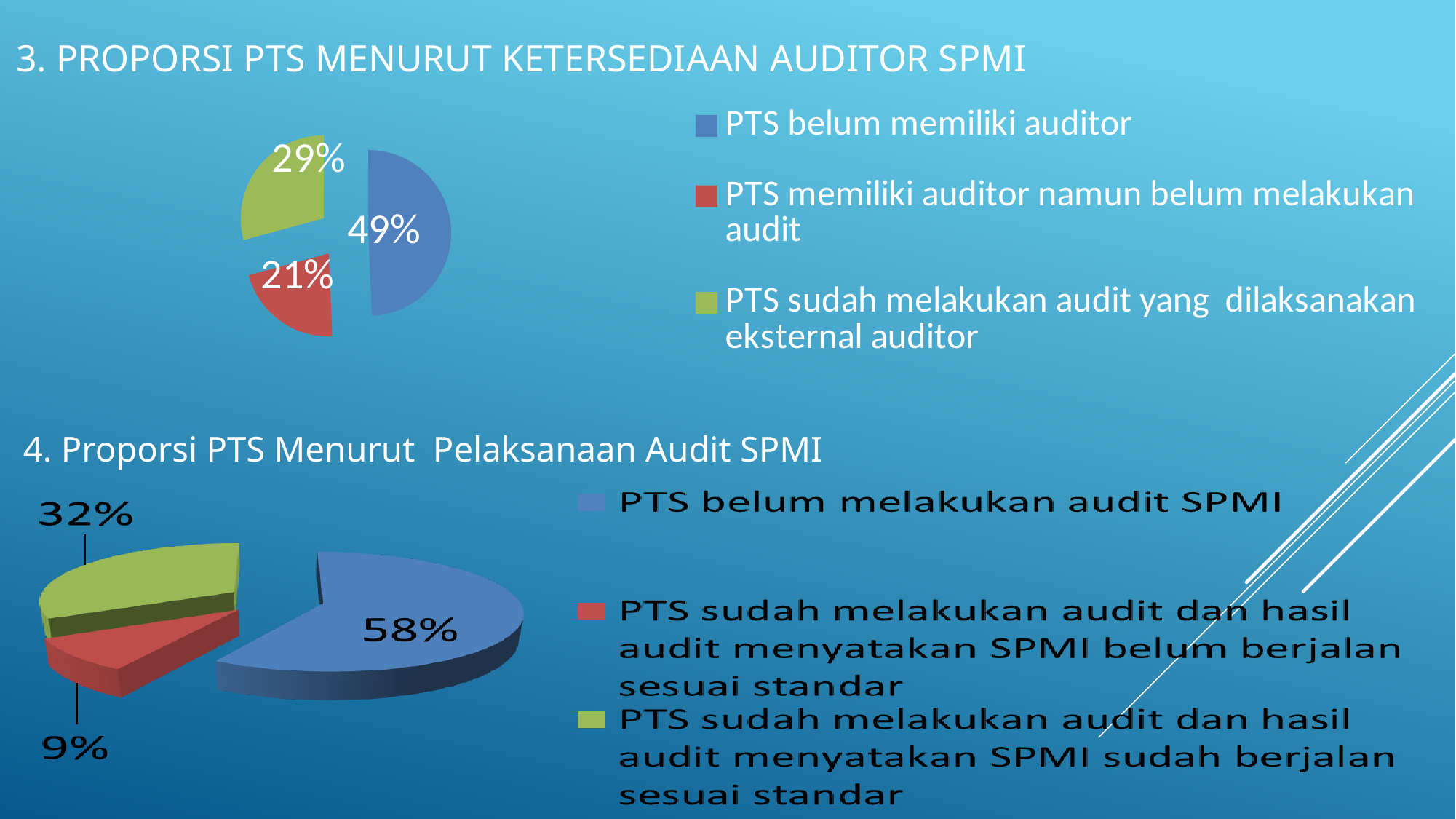
In the bottom chart (Proporsi PTS Menurut Pelaksanaan Audit SPMI), what share of PTS sudah melakukan audit dan hasil audit menyatakan SPMI belum berjalan sesuai standar? 9% In the bottom chart (Proporsi PTS Menurut Pelaksanaan Audit SPMI), what share of PTS sudah melakukan audit dan hasil audit menyatakan SPMI sudah berjalan sesuai standar? 32% In the top chart (Proporsi PTS Menurut Ketersediaan Auditor SPMI), what is the difference in percentage points between the 49% slice and the 21% slice? 28 In the bottom chart (Proporsi PTS Menurut Pelaksanaan Audit SPMI), what share of PTS belum melakukan audit SPMI? 58% How many slices does the bottom chart (Proporsi PTS Menurut Pelaksanaan Audit SPMI) have? 3 In the bottom chart (Proporsi PTS Menurut Pelaksanaan Audit SPMI), which category has the smallest slice? PTS sudah melakukan audit dan hasil audit menyatakan SPMI belum berjalan sesuai standar In the top chart (Proporsi PTS Menurut Ketersediaan Auditor SPMI), which category has the smallest slice? PTS memiliki auditor namun belum melakukan audit In the top chart (Proporsi PTS Menurut Ketersediaan Auditor SPMI), which category has the largest slice? PTS belum memiliki auditor What kind of chart is the top chart (Proporsi PTS Menurut Ketersediaan Auditor SPMI)? Pie chart